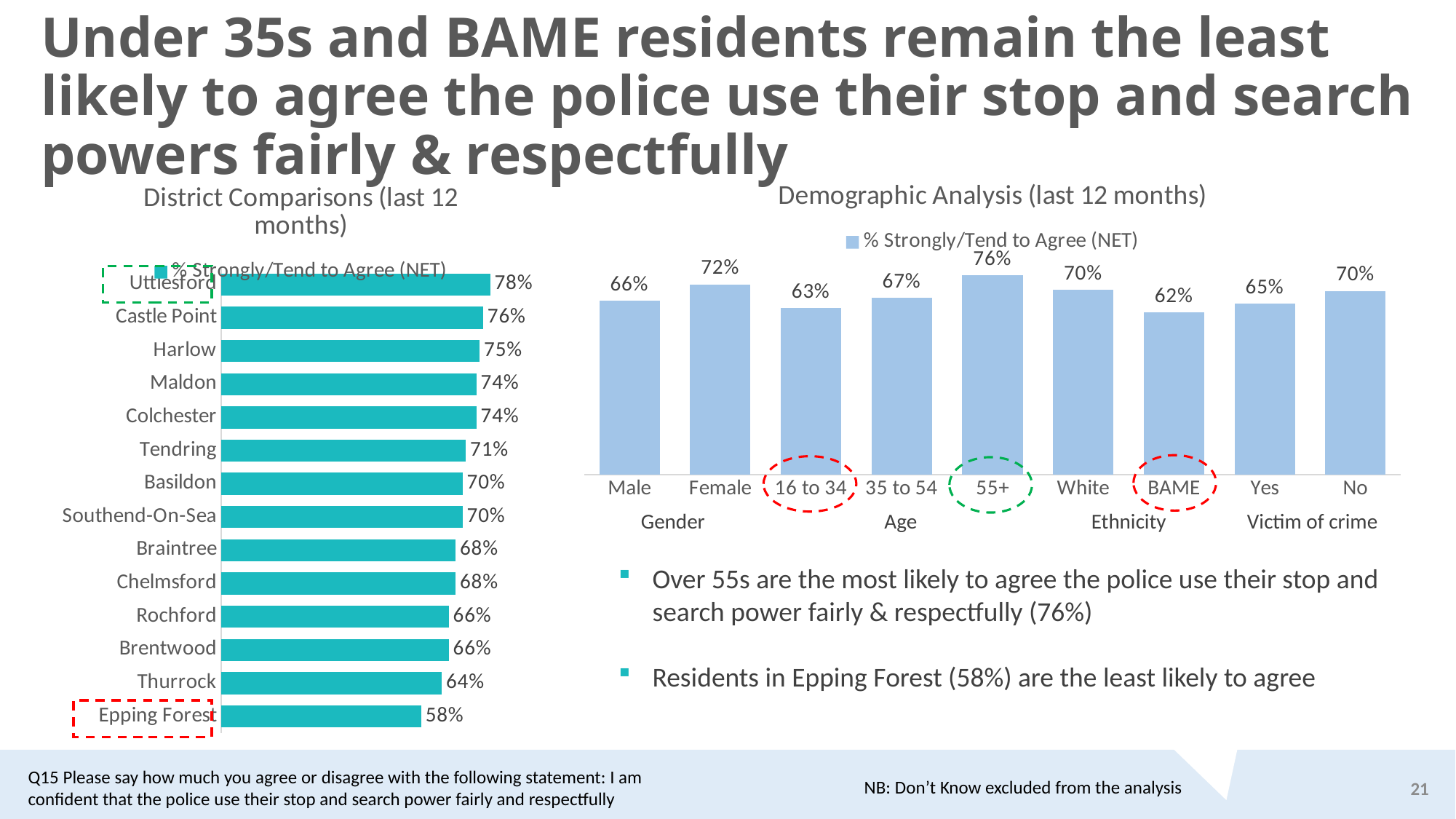
In the District Comparisons chart, what is the difference between Uttlesford and Epping Forest? 20 percentage points In the Demographic Analysis chart, how many categories are shown? 9 In the District Comparisons chart, which is larger, Tendring or Thurrock? Tendring In the Demographic Analysis chart, what series does the legend list? % Strongly/Tend to Agree (NET) In the District Comparisons chart, how many districts are shown? 14 In the Demographic Analysis chart, what is the difference between Female and Male? 6 percentage points In the District Comparisons chart, which district has the lowest value? Epping Forest In the District Comparisons chart, which district has the highest value? Uttlesford In the Demographic Analysis chart, which category has the highest value? 55+ In the District Comparisons chart, what is the value for Harlow? 75% What type of chart is the Demographic Analysis chart? Bar chart In the Demographic Analysis chart, what is the value for BAME? 62%